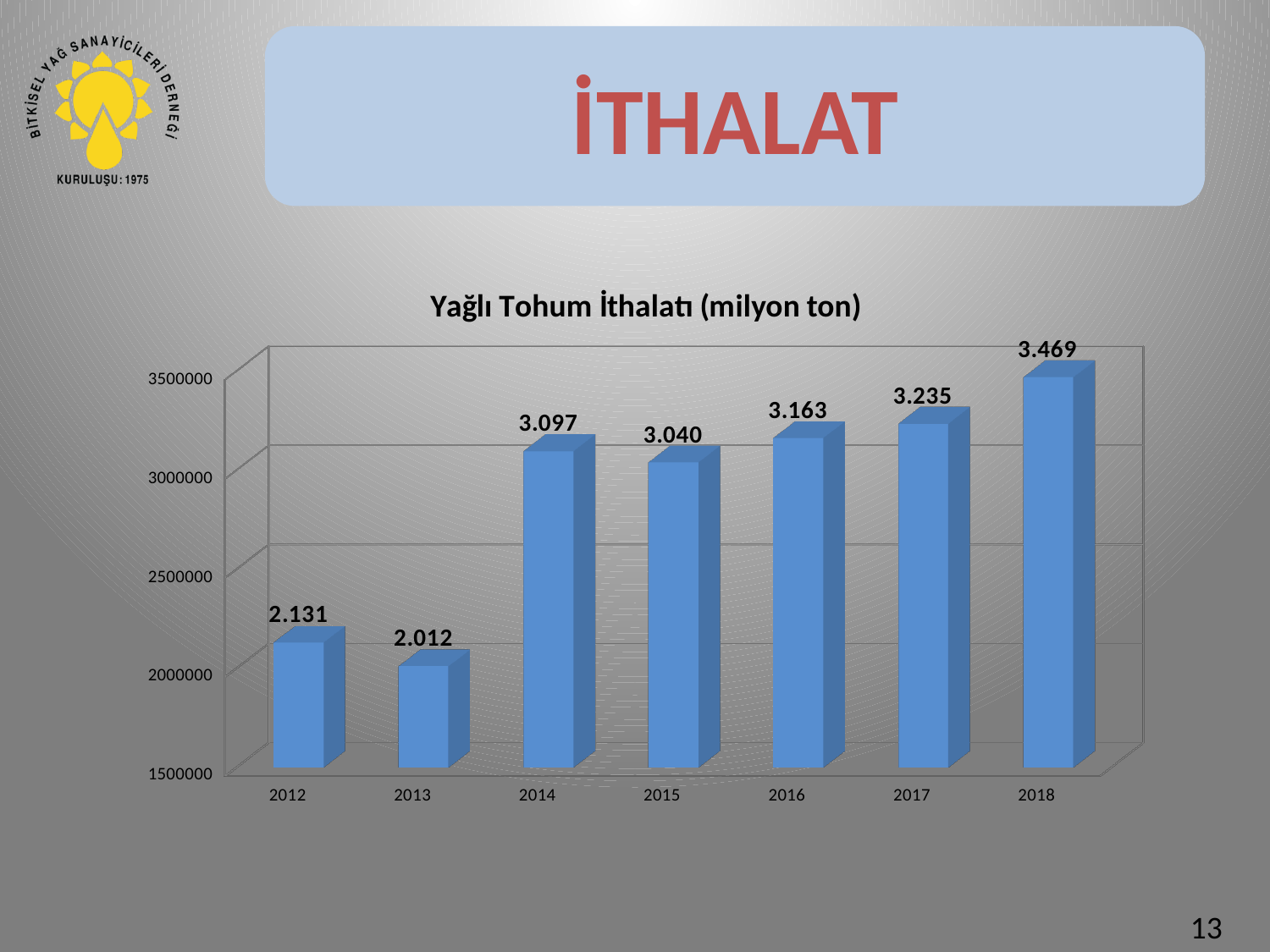
What is the value shown for 2015 in the Yağlı Tohum İthalatı chart? 3.040 What is the difference between the values for 2018 and 2012 in the Yağlı Tohum İthalatı chart? 1.338 What is the title of the chart on the slide? Yağlı Tohum İthalatı (milyon ton) What is the value shown for 2013 in the Yağlı Tohum İthalatı chart? 2.012 What kind of chart is used to show Yağlı Tohum İthalatı? bar chart Does the value in the Yağlı Tohum İthalatı chart rise or fall from 2015 to 2018? rise Which year has the lowest value in the Yağlı Tohum İthalatı chart? 2013 What is the value shown for 2018 in the Yağlı Tohum İthalatı chart? 3.469 Is the value for 2013 in the Yağlı Tohum İthalatı chart greater or less than 2500000? less Which year has the larger value in the Yağlı Tohum İthalatı chart, 2014 or 2015? 2014 Which year has the highest value in the Yağlı Tohum İthalatı chart? 2018 How many years are shown on the x axis of the Yağlı Tohum İthalatı chart? 7